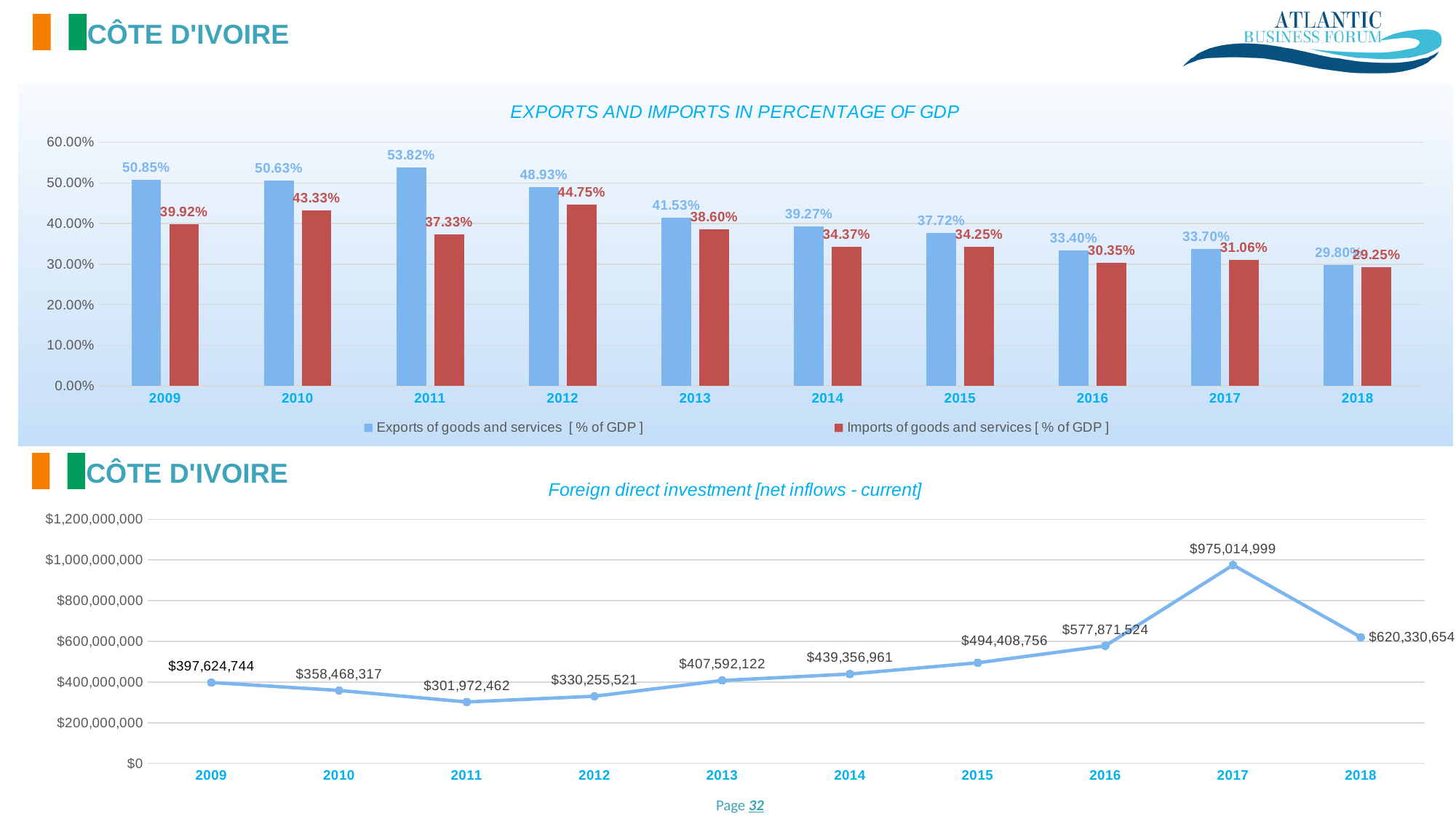
In the 'EXPORTS AND IMPORTS IN PERCENTAGE OF GDP' chart, which year has the lowest Imports of goods and services value? 2018 In the 'EXPORTS AND IMPORTS IN PERCENTAGE OF GDP' chart, what is the value of Imports of goods and services for 2012? 44.75% In the 'Foreign direct investment [net inflows - current]' chart, how many years are plotted? 10 What type of chart is the 'Foreign direct investment [net inflows - current]' chart? Line chart In the 'Foreign direct investment [net inflows - current]' chart, which year has the lowest value? 2011 In the 'Foreign direct investment [net inflows - current]' chart, what is the value for 2017? $975,014,999 In the 'Foreign direct investment [net inflows - current]' chart, is the value for 2016 larger or smaller than the value for 2018? Smaller In the 'EXPORTS AND IMPORTS IN PERCENTAGE OF GDP' chart, how many series does the legend list? 2 In the 'EXPORTS AND IMPORTS IN PERCENTAGE OF GDP' chart, which year has the highest Exports of goods and services value? 2011 In the 'EXPORTS AND IMPORTS IN PERCENTAGE OF GDP' chart, what is the difference between Exports and Imports in 2009? 10.93% In the 'EXPORTS AND IMPORTS IN PERCENTAGE OF GDP' chart, what is the overall trend of Exports of goods and services from 2011 to 2018? Falling In the 'EXPORTS AND IMPORTS IN PERCENTAGE OF GDP' chart, what is the value of Exports of goods and services for 2011? 53.82%